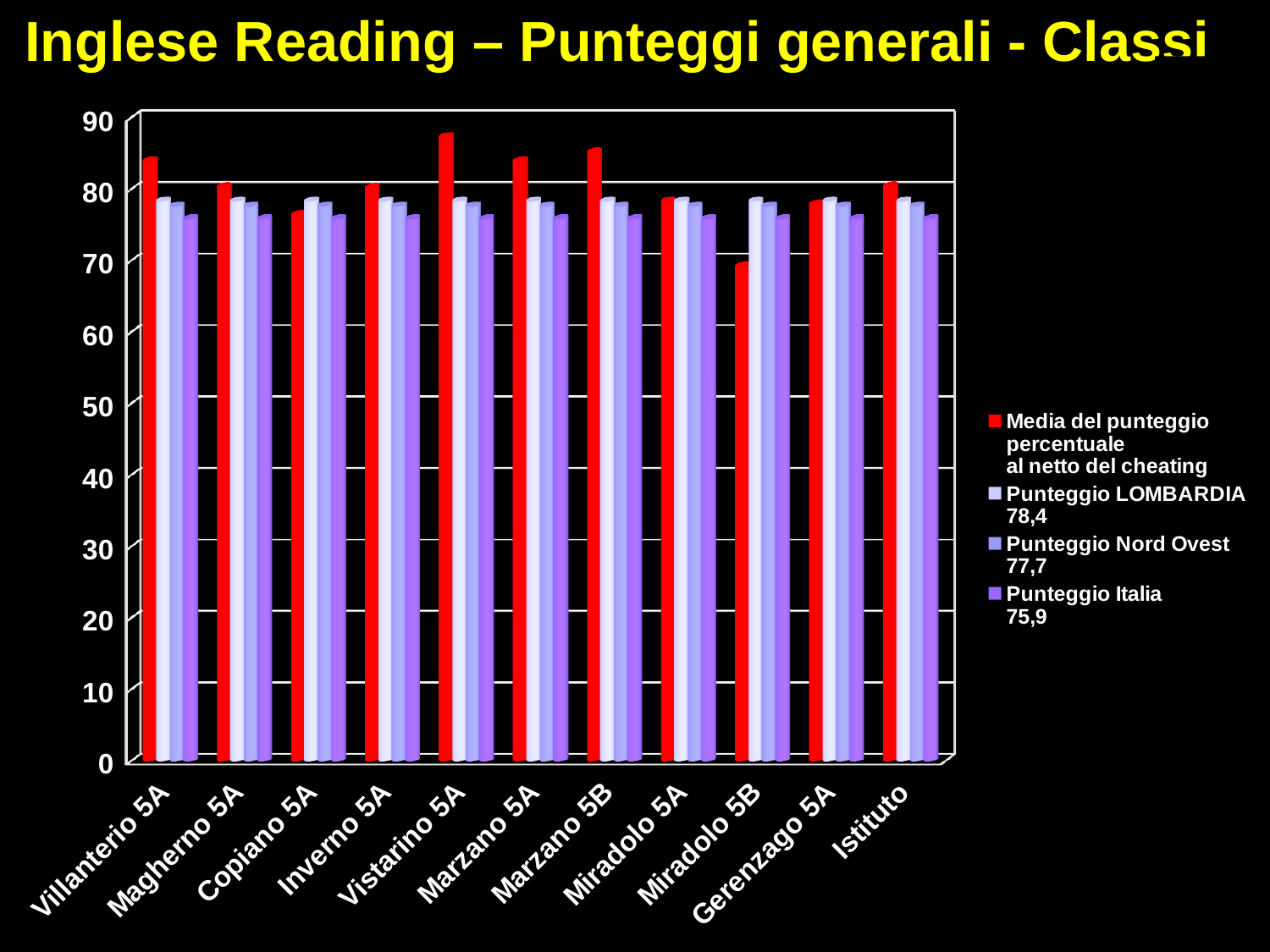
What is the Punteggio Nord Ovest value given in the legend? 77,7 What is the title of the chart on the slide? Inglese Reading – Punteggi generali - Classi What is the Punteggio LOMBARDIA value given in the legend? 78,4 Which has the larger red bar, Villanterio 5A or Copiano 5A? Villanterio 5A Is the red bar value for Vistarino 5A greater or less than 80? greater What kind of chart is shown on the slide? bar chart Which class has the lowest 'Media del punteggio percentuale al netto del cheating' (red bar)? Miradolo 5B How many categories are shown along the x axis? 11 How many series does the legend list? 4 What is the Punteggio Italia value given in the legend? 75,9 Which class has the highest 'Media del punteggio percentuale al netto del cheating' (red bar)? Vistarino 5A